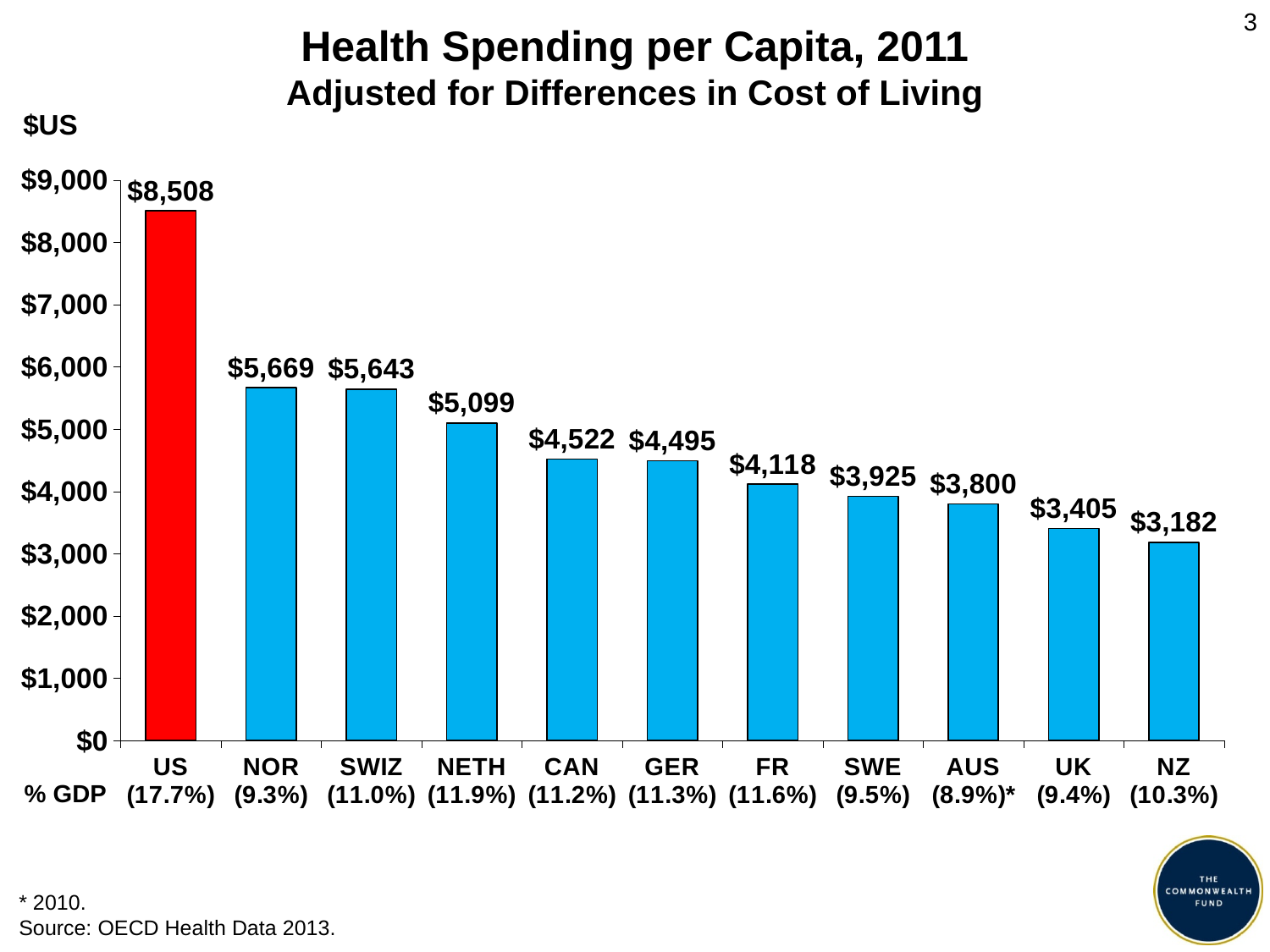
How many countries are shown in the chart? 11 Is the value for UK greater or less than $3,000? greater What is the health spending per capita for NETH? $5,099 What is the health spending per capita for SWE? $3,925 What kind of chart is shown on the slide? bar chart What is the health spending per capita for the US? $8,508 Which country has the highest health spending per capita? US What is the difference in health spending per capita between CAN and GER? $27 What percentage of GDP is shown for the US below the chart? 17.7% What is the difference in health spending per capita between the US and NOR? $2,839 Which country has the lowest health spending per capita? NZ Which has higher health spending per capita, FR or AUS? FR